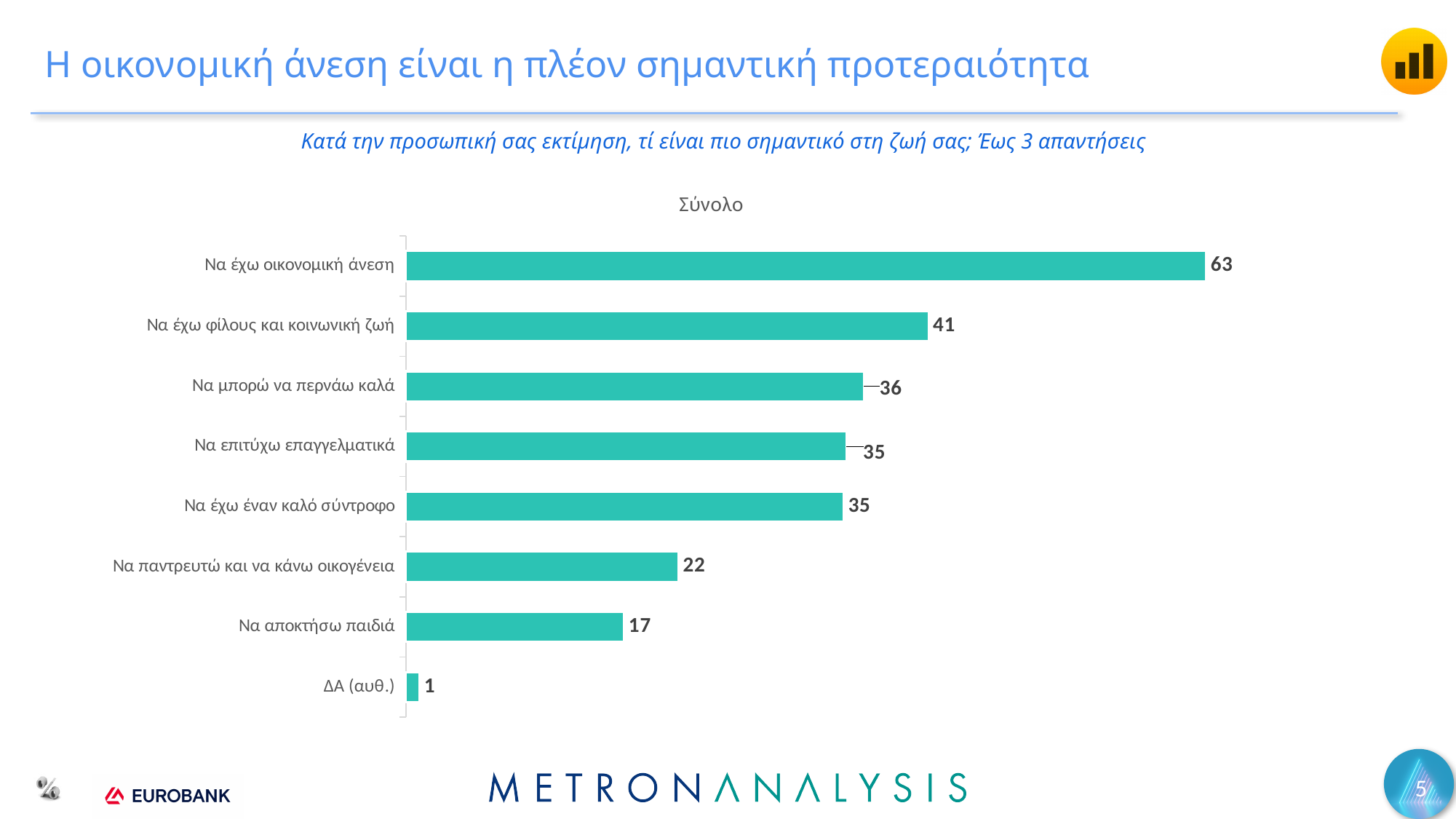
Which category has the lowest value? ΔΑ (αυθ.) How many categories are shown in the chart? 8 Which is larger: the value for "Να μπορώ να περνάω καλά" or the value for "Να παντρευτώ και να κάνω οικογένεια"? Να μπορώ να περνάω καλά What is the value for "Να έχω φίλους και κοινωνική ζωή"? 41 What is the difference between the values for "Να παντρευτώ και να κάνω οικογένεια" and "Να αποκτήσω παιδιά"? 5 What is the value for "Να παντρευτώ και να κάνω οικογένεια"? 22 Which category has the highest value? Να έχω οικονομική άνεση What kind of chart is shown on the slide? Bar chart What is the value for "Να έχω οικονομική άνεση"? 63 What is the value for "Να αποκτήσω παιδιά"? 17 What is the title shown above the chart? Σύνολο What is the difference between the values for "Να έχω οικονομική άνεση" and "Να έχω φίλους και κοινωνική ζωή"? 22